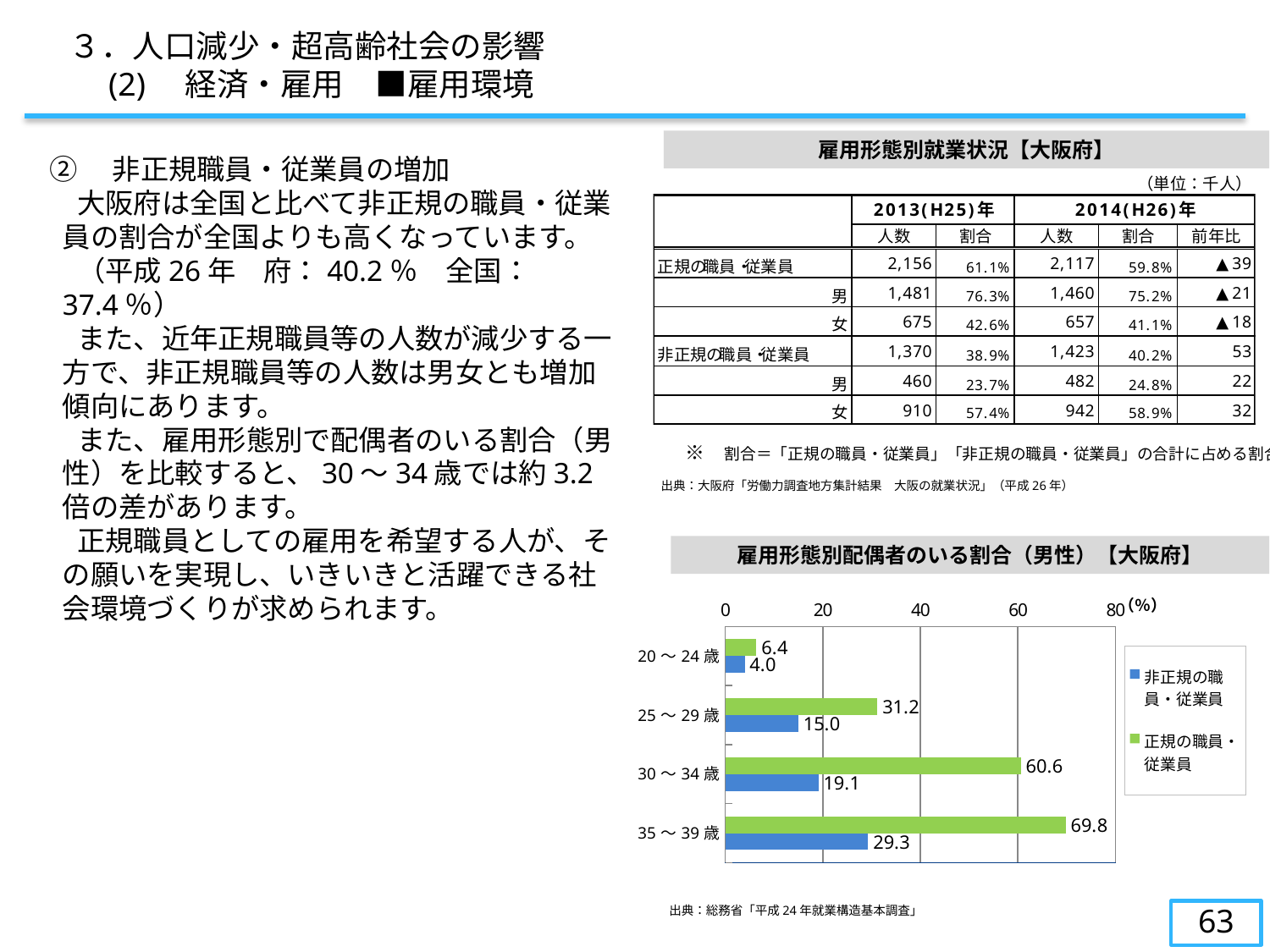
In the chart 雇用形態別配偶者のいる割合（男性）【大阪府】, which age group has the lowest value for 非正規の職員・従業員? 20～24歳 In the chart 雇用形態別配偶者のいる割合（男性）【大阪府】, is the value for 正規の職員・従業員 in the 35～39歳 group greater or less than 60? greater In the chart 雇用形態別配偶者のいる割合（男性）【大阪府】, what is the value for 非正規の職員・従業員 in the 35～39歳 group? 29.3 What kind of chart is shown under the title 雇用形態別配偶者のいる割合（男性）【大阪府】? bar chart How many series does the legend of the chart 雇用形態別配偶者のいる割合（男性）【大阪府】 list? 2 In the chart 雇用形態別配偶者のいる割合（男性）【大阪府】, which is larger in the 25～29歳 group: 正規の職員・従業員 or 非正規の職員・従業員? 正規の職員・従業員 In the chart 雇用形態別配偶者のいる割合（男性）【大阪府】, which age group has the highest value for 正規の職員・従業員? 35～39歳 In the chart 雇用形態別配偶者のいる割合（男性）【大阪府】, do the values for 非正規の職員・従業員 rise or fall as the age groups get older? rise How many age groups are shown in the chart 雇用形態別配偶者のいる割合（男性）【大阪府】? 4 In the chart 雇用形態別配偶者のいる割合（男性）【大阪府】, what is the value for 正規の職員・従業員 in the 30～34歳 group? 60.6 In the chart 雇用形態別配偶者のいる割合（男性）【大阪府】, what is the difference between 正規の職員・従業員 and 非正規の職員・従業員 in the 30～34歳 group? 41.5 In the chart 雇用形態別配偶者のいる割合（男性）【大阪府】, what is the value for 非正規の職員・従業員 in the 25～29歳 group? 15.0